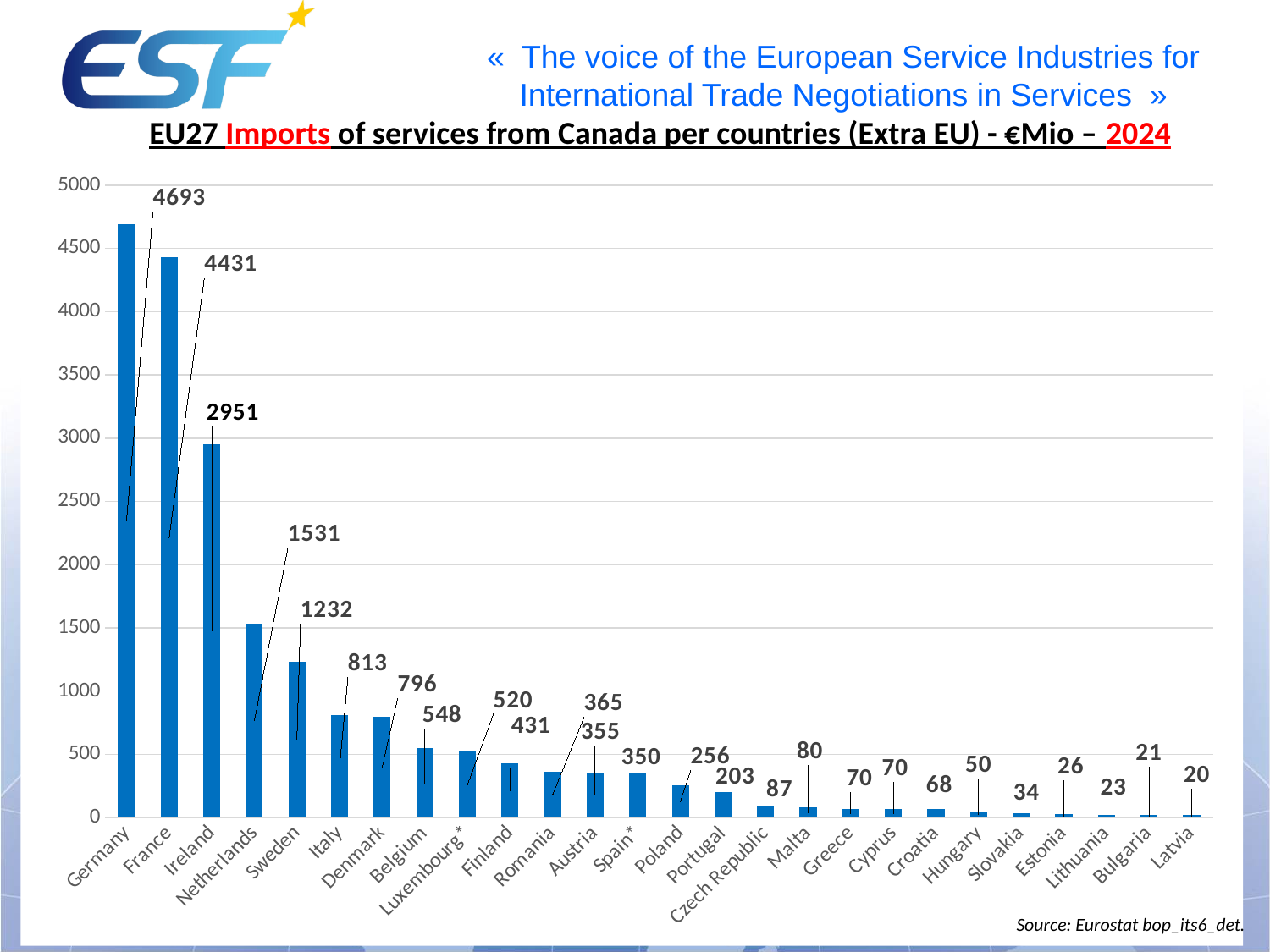
What kind of chart is this? bar chart What is the value for Ireland? 2951 Which is larger, the value for Sweden or the value for Italy? Sweden What is the difference between the values for Germany and France? 262 How many countries are shown on the chart? 26 Is the value for Netherlands greater or less than 1500? greater Do the values rise or fall from left to right along the x axis? fall Which country has the lowest value? Latvia What is the value for Poland? 256 What is the value for Germany? 4693 What is the value for Czech Republic? 87 Which country has the highest value? Germany